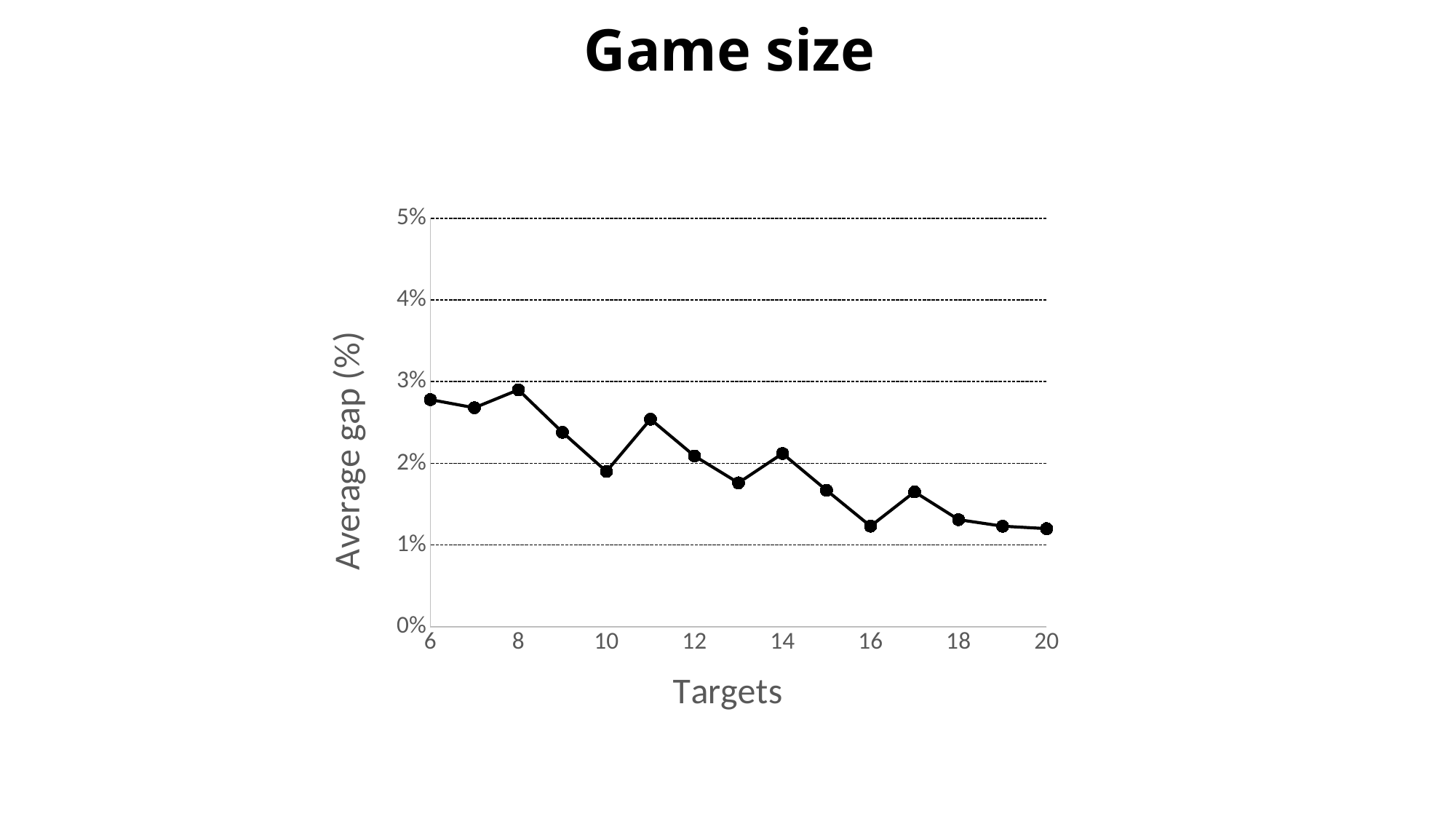
What kind of chart is shown on the slide? line chart Is the average gap at 8 targets greater or less than 3%? less Which has a larger average gap: 8 targets or 16 targets? 8 targets What is the label of the x axis? Targets Is the average gap at 16 targets greater or less than 2%? less Is the average gap at 6 targets greater or less than 2%? greater At which number of targets is the average gap highest? 8 What is the title of the chart? Game size Overall, does the average gap rise or fall as the number of targets increases from 6 to 20? fall How many data points are plotted on the line? 15 Which has a larger average gap: 11 targets or 13 targets? 11 targets